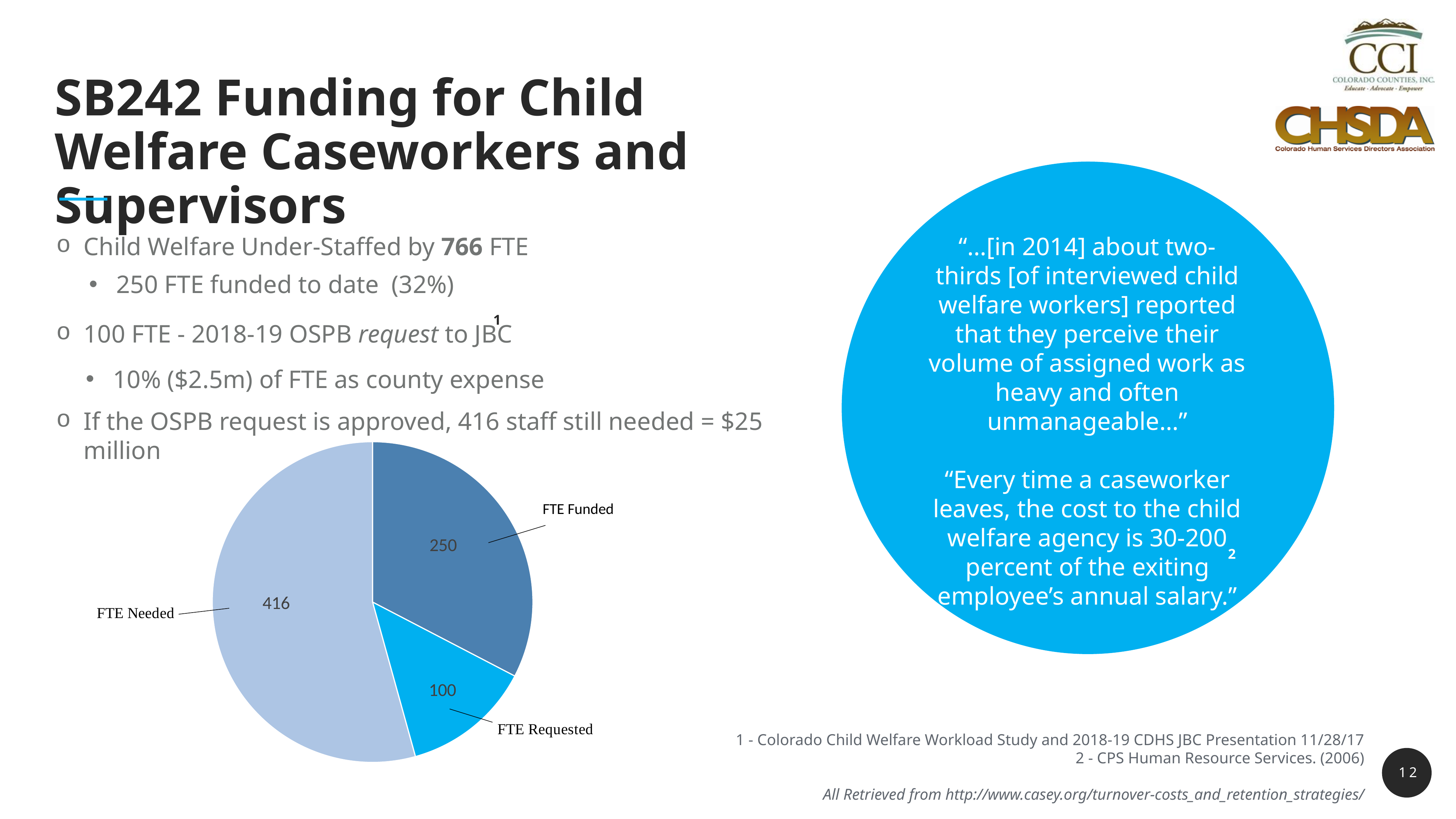
How many slices does the pie chart have? 3 What is the value of the FTE Funded slice in the pie chart? 250 What is the value of the FTE Requested slice in the pie chart? 100 What is the difference between the FTE Funded and FTE Requested values in the pie chart? 150 What kind of chart is shown on the slide? pie chart What is the value of the FTE Needed slice in the pie chart? 416 Which slice of the pie chart is drawn in the darkest blue? FTE Funded What is the difference between the FTE Needed and FTE Funded values in the pie chart? 166 Which slice of the pie chart has the smallest value? FTE Requested Which slice of the pie chart has the largest value? FTE Needed Which is larger in the pie chart, FTE Funded or FTE Requested? FTE Funded What is the total of all three slices in the pie chart? 766